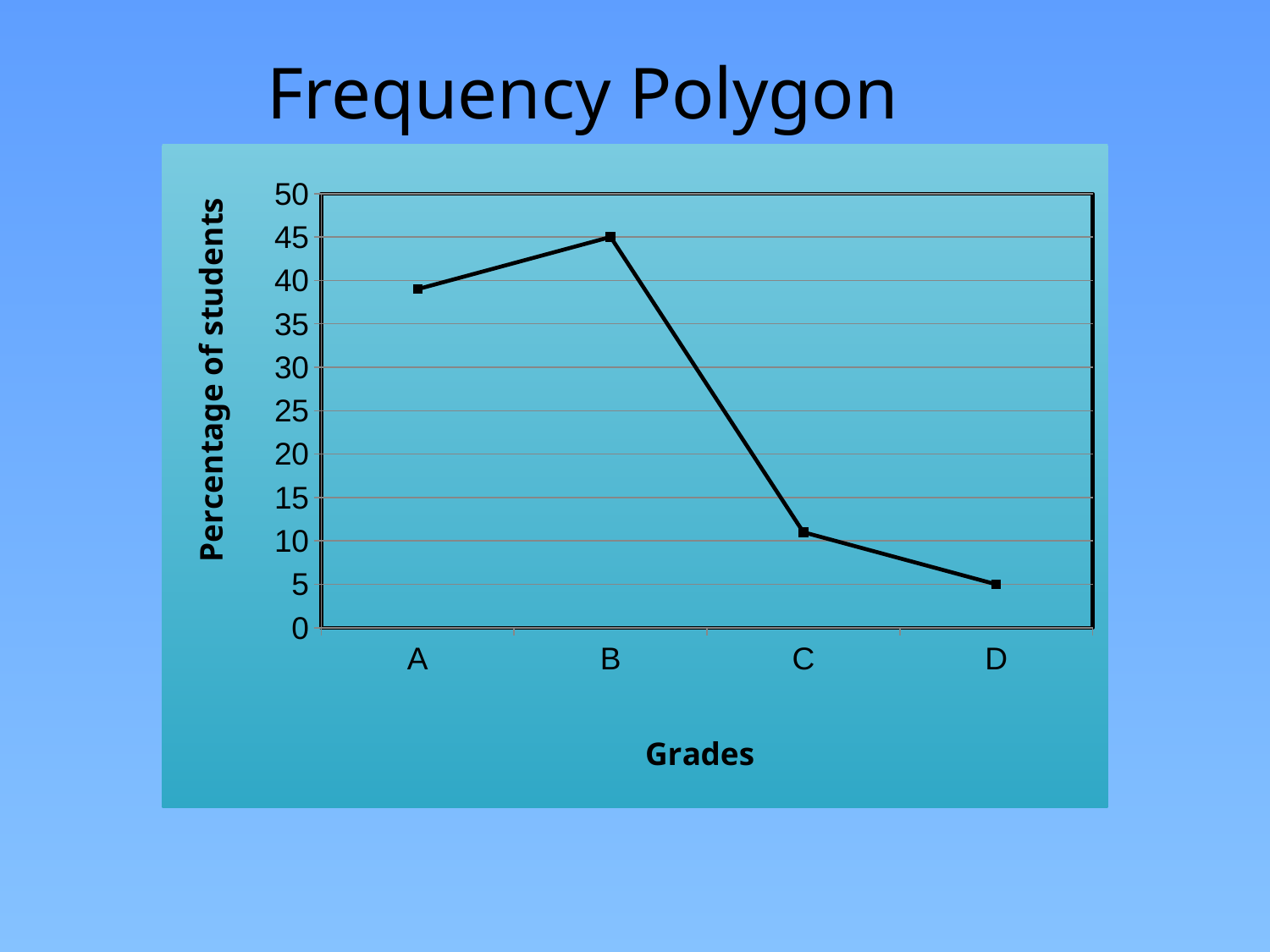
What is the percentage of students for grade B? 45 What is the label of the y axis? Percentage of students What type of chart is shown on the slide? line chart Which grade has a larger percentage of students, A or C? A What is the percentage of students for grade D? 5 Is the value for grade C greater or less than 15? less Is the value for grade A greater or less than 35? greater Which grade has the highest percentage of students? B Which grade has the lowest percentage of students? D How many grade categories are plotted on the x axis? 4 What is the difference between the percentage of students for grade B and grade D? 40